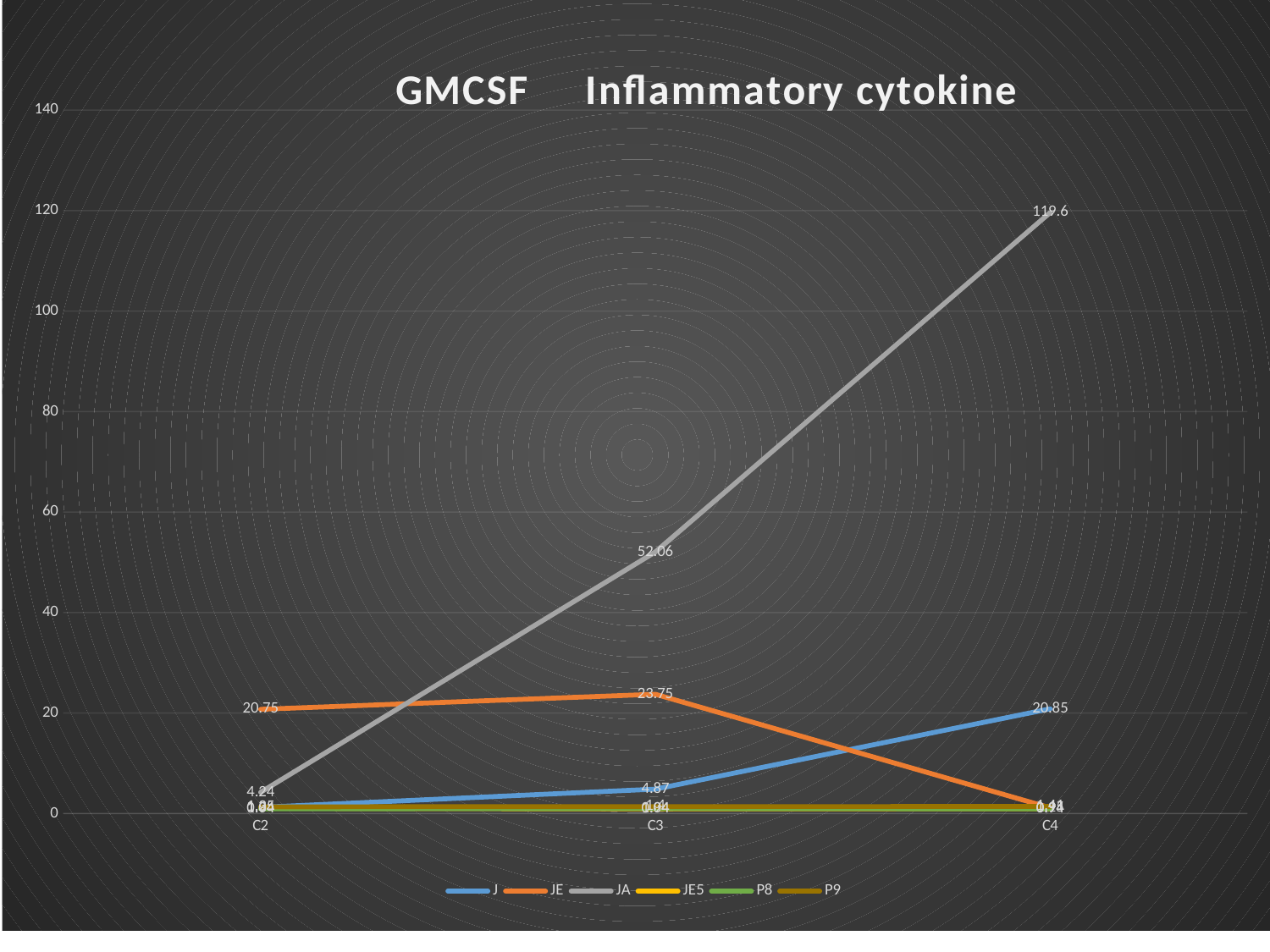
At C3, which is larger: the JE value or the J value? JE What is the difference between the JE values at C3 and C2? 3 How many series does the legend list? 6 How many categories are shown on the x axis? 3 What is the difference between the JA values at C4 and C3? 67.54 What is the value of the JE series at C2? 20.75 What is the value of the JA series at C3? 52.06 What is the value of the JA series at C4? 119.6 What kind of chart is shown on the slide? line chart Does the JA series rise or fall from C2 to C4? rise What is the value of the J series at C4? 20.85 Which series has the highest value at C4? JA